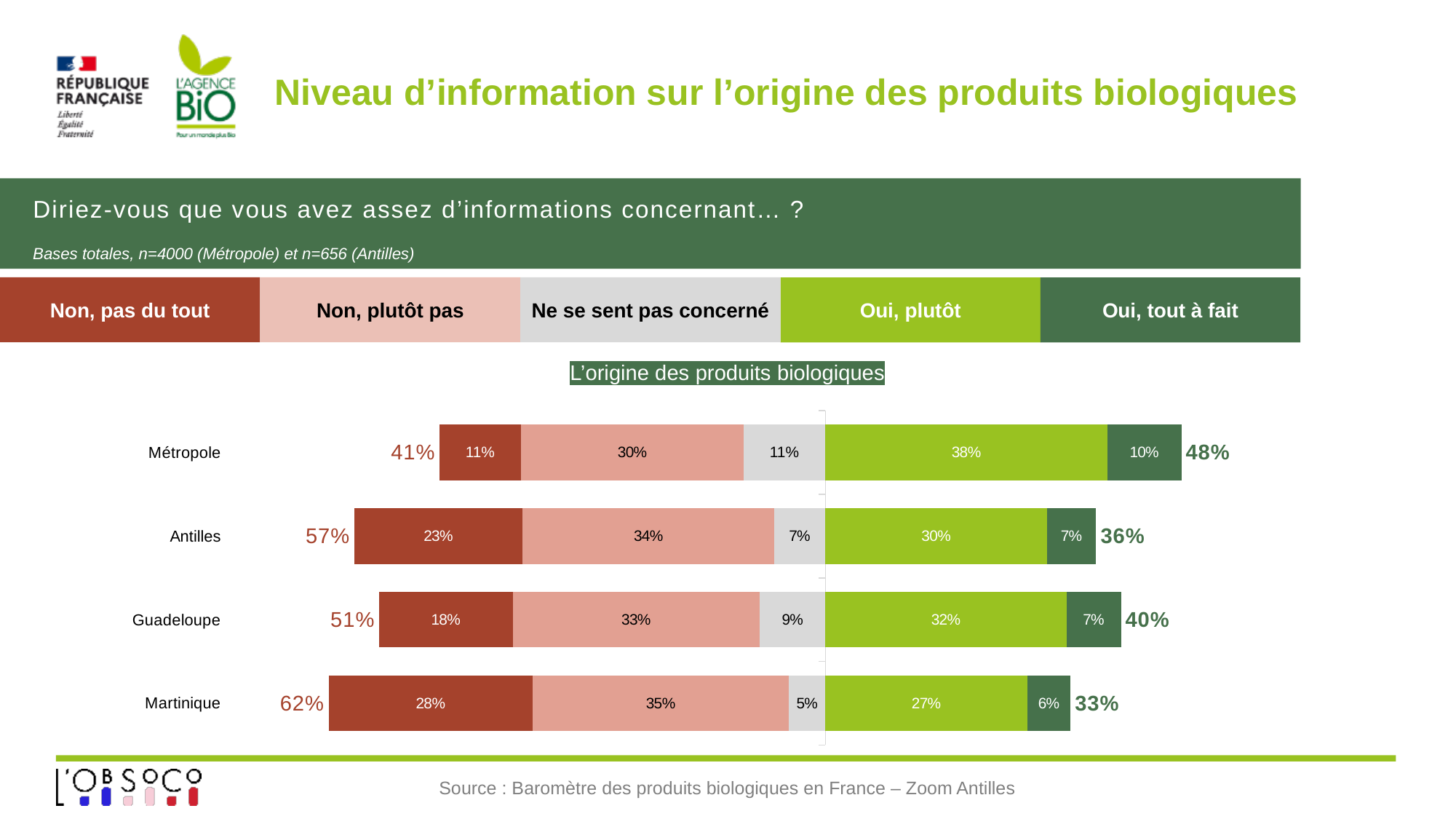
Which has a larger "Oui, plutôt" value, Guadeloupe or Antilles? Guadeloupe What kind of chart is shown on the slide? Stacked bar chart What is the combined "Non" total (Non, pas du tout + Non, plutôt pas) shown for Guadeloupe? 51% What percentage of Martinique respondents answered "Non, pas du tout"? 28% What is the "Oui, plutôt" value for Métropole? 38% What is the combined "Oui" total shown for Métropole? 48% What is the title of the chart? L'origine des produits biologiques Which category has the lowest "Ne se sent pas concerné" value? Martinique What is the difference between the "Non, plutôt pas" values for Antilles and Métropole? 4 percentage points How many categories (regions) are shown in the chart? 4 How many series does the legend list? 5 Which category has the highest "Non, pas du tout" value? Martinique